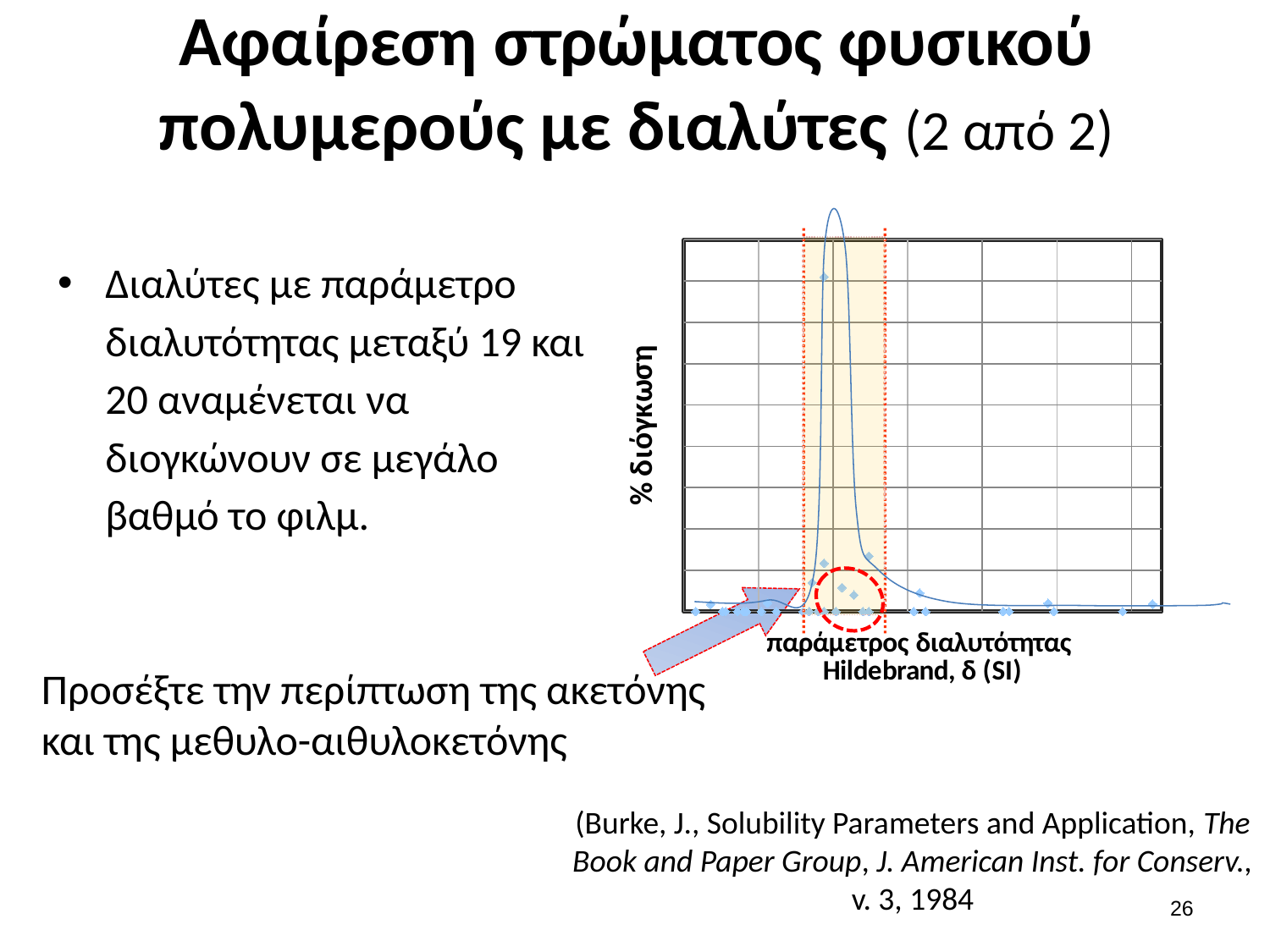
What is the title of the vertical axis of the chart? % διόγκωση What kind of chart is shown on the slide? scatter chart with a fitted curve What is the title of the horizontal axis of the chart? παράμετρος διαλυτότητας Hildebrand, δ (SI) Moving along the x axis, does the fitted curve rise steadily, fall steadily, or rise to a single sharp peak and then fall? rises to a single sharp peak and then falls